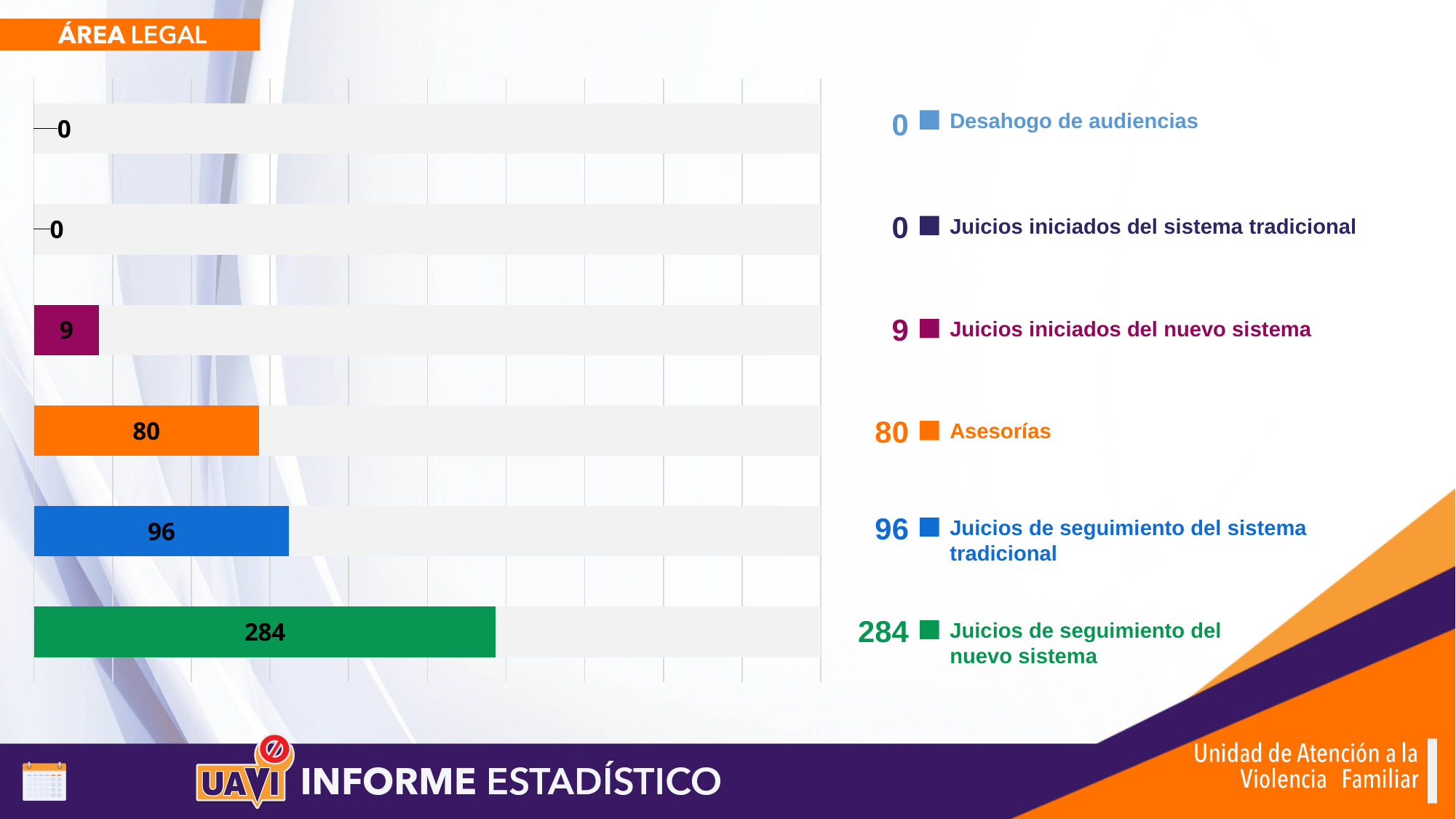
What is the value for Asesorías? 80 What is the value for Desahogo de audiencias? 0 What colour is the bar for Asesorías? orange Which category has the highest value? Juicios de seguimiento del nuevo sistema Which is larger, Asesorías or Juicios de seguimiento del sistema tradicional? Juicios de seguimiento del sistema tradicional What kind of chart is shown on the slide? bar chart How many categories are shown in the chart? 6 What is the value for Juicios de seguimiento del nuevo sistema? 284 How many categories have a value of 0? 2 What is the difference between Juicios de seguimiento del nuevo sistema and Juicios de seguimiento del sistema tradicional? 188 What is the value for Juicios iniciados del nuevo sistema? 9 What is the difference between Juicios de seguimiento del sistema tradicional and Asesorías? 16